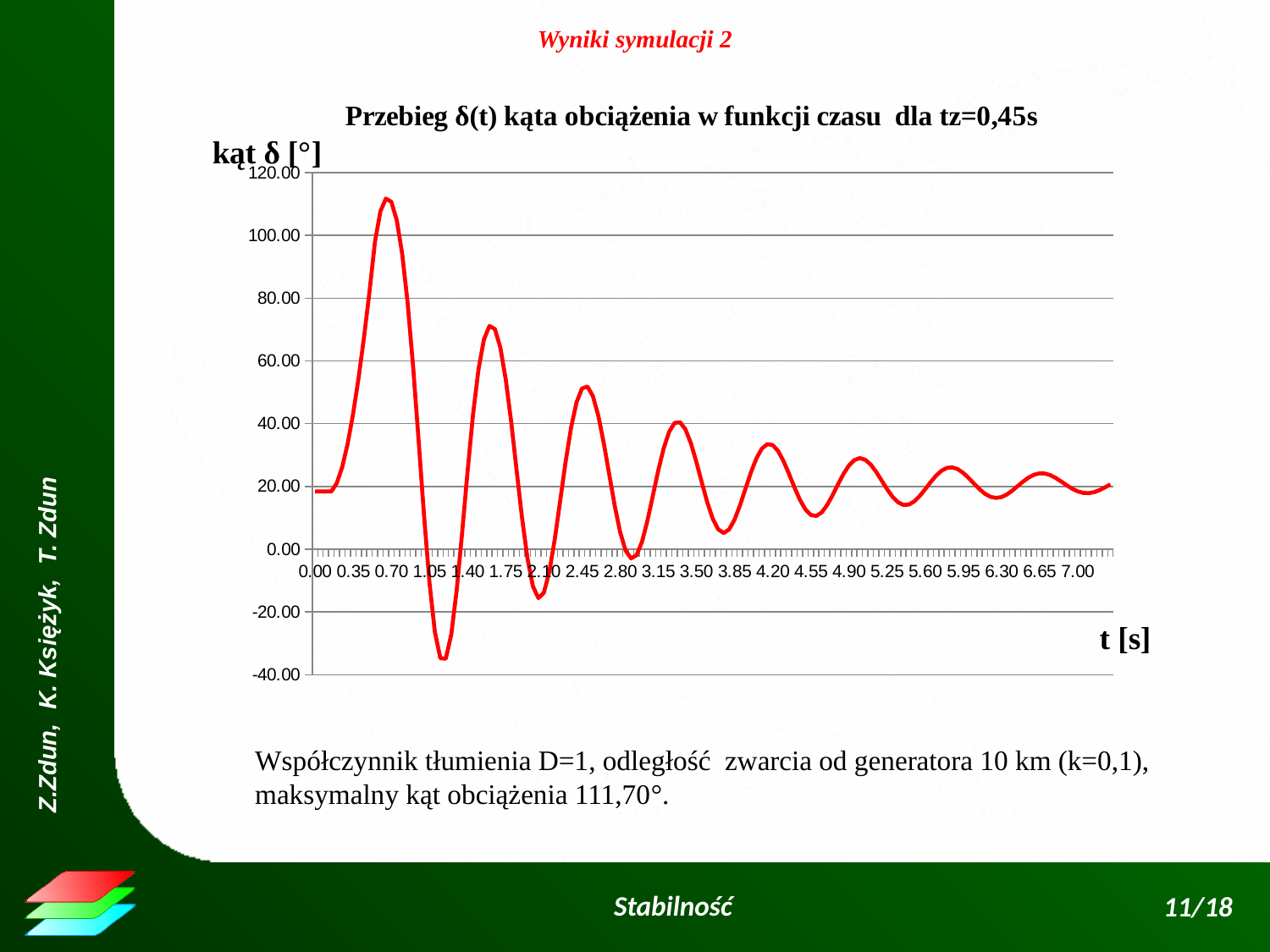
Is the value of the curve at t=0.70 greater or less than 100.00? greater Is the lowest point of the curve greater or less than -20.00? less Do the peaks of the oscillation rise or fall as time increases along the x axis? fall According to the text below the chart, what is the maximum load angle reached? 111,70° What kind of chart is shown on the slide? line chart What is the label of the horizontal axis of the chart? t [s] Is the value of the curve at t=3.85 greater or less than 20.00? less How many data series are plotted on the chart? 1 What is the title of the chart? Przebieg δ(t) kąta obciążenia w funkcji czasu dla tz=0,45s